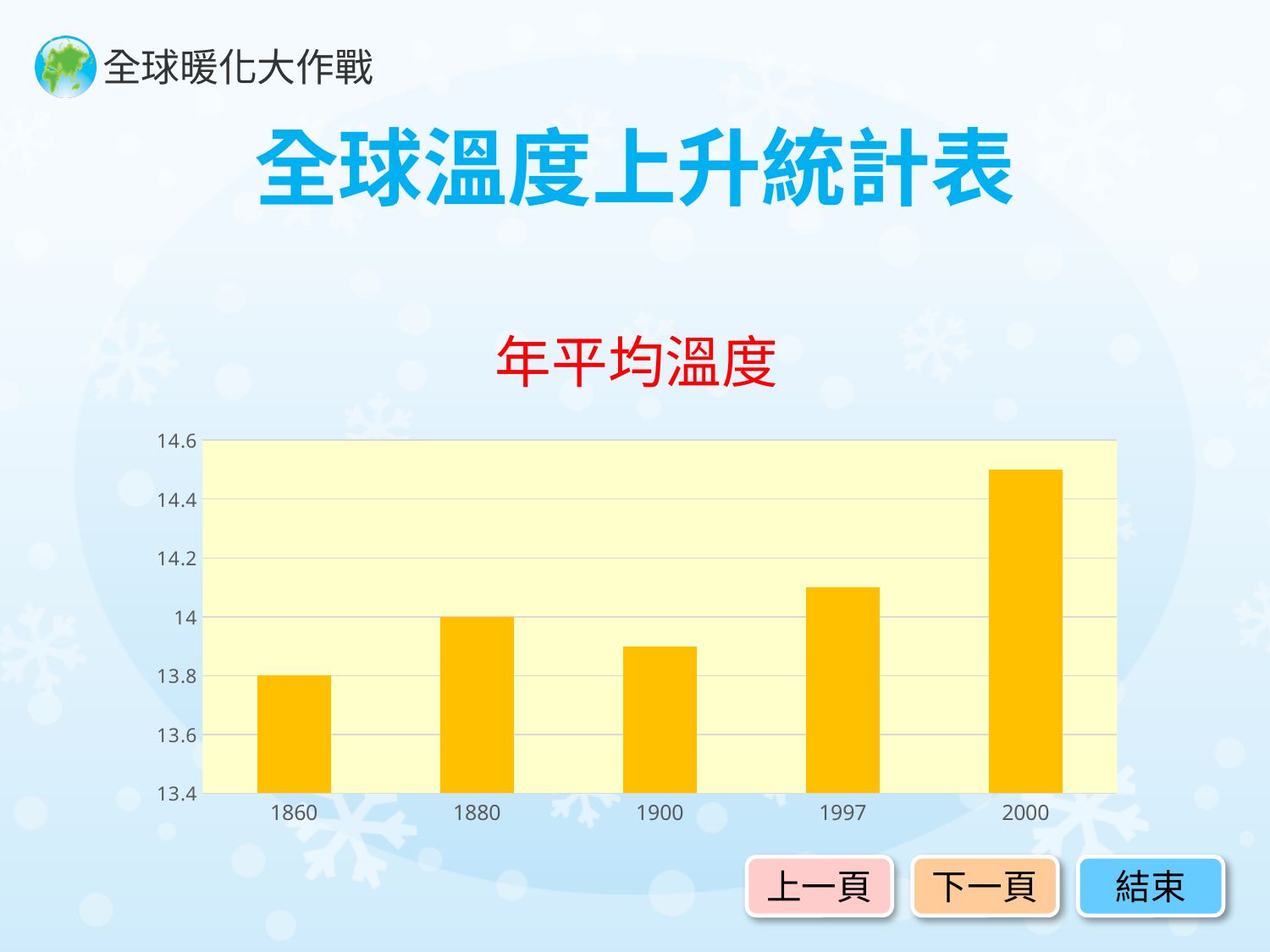
Is the value for 1997 greater or less than 14.2? less What is the difference between the values for 1880 and 1860? 0.2 What is the average temperature value for 1880? 14 Which year has the lowest average temperature in the chart? 1860 Is the value for 1900 greater or less than 14? less What is the title of the chart? 年平均溫度 Is the value for 2000 greater or less than 14.4? greater Which year has the highest average temperature in the chart? 2000 What is the average temperature value for 1860? 13.8 Which is larger, the value for 1997 or the value for 1900? 1997 What kind of chart is shown on the slide? bar chart How many years are shown on the x axis of the chart? 5